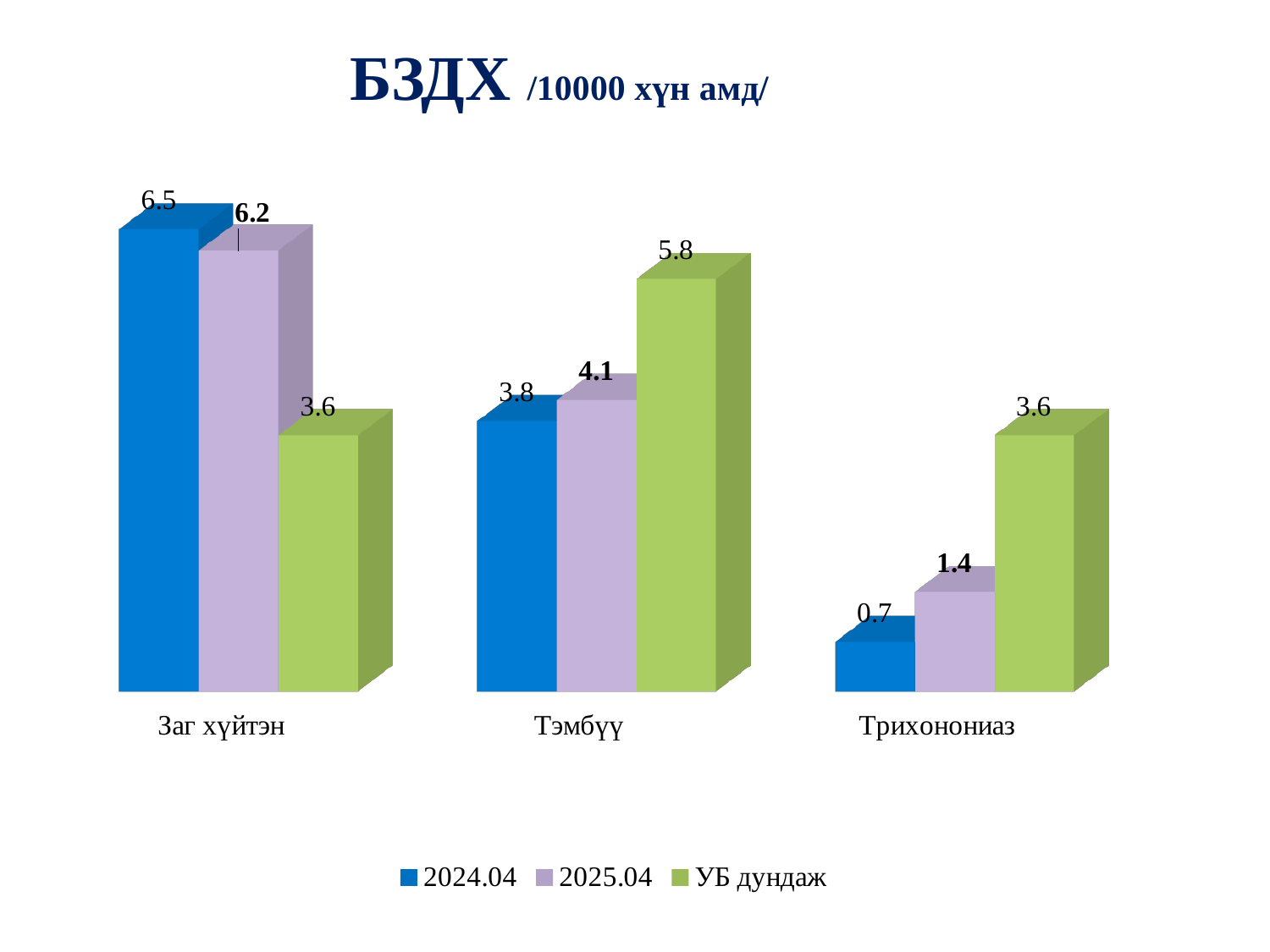
What is the difference between the 2024.04 and 2025.04 values for Трихонониаз? 0.7 What is the value for Заг хүйтэн in the 2024.04 series? 6.5 What is the difference between the УБ дундаж value and the 2025.04 value for Тэмбүү? 1.7 How many categories are shown on the x axis? 3 What is the value for Тэмбүү in the 2025.04 series? 4.1 What kind of chart is shown on the slide? Bar chart For Тэмбүү, which is larger: the 2024.04 value or the УБ дундаж value? УБ дундаж Which category has the highest value in the 2025.04 series? Заг хүйтэн What is the УБ дундаж value for Трихонониаз? 3.6 Which category has the lowest value in the 2024.04 series? Трихонониаз How many series does the legend list? 3 What is the value for Трихонониаз in the 2024.04 series? 0.7